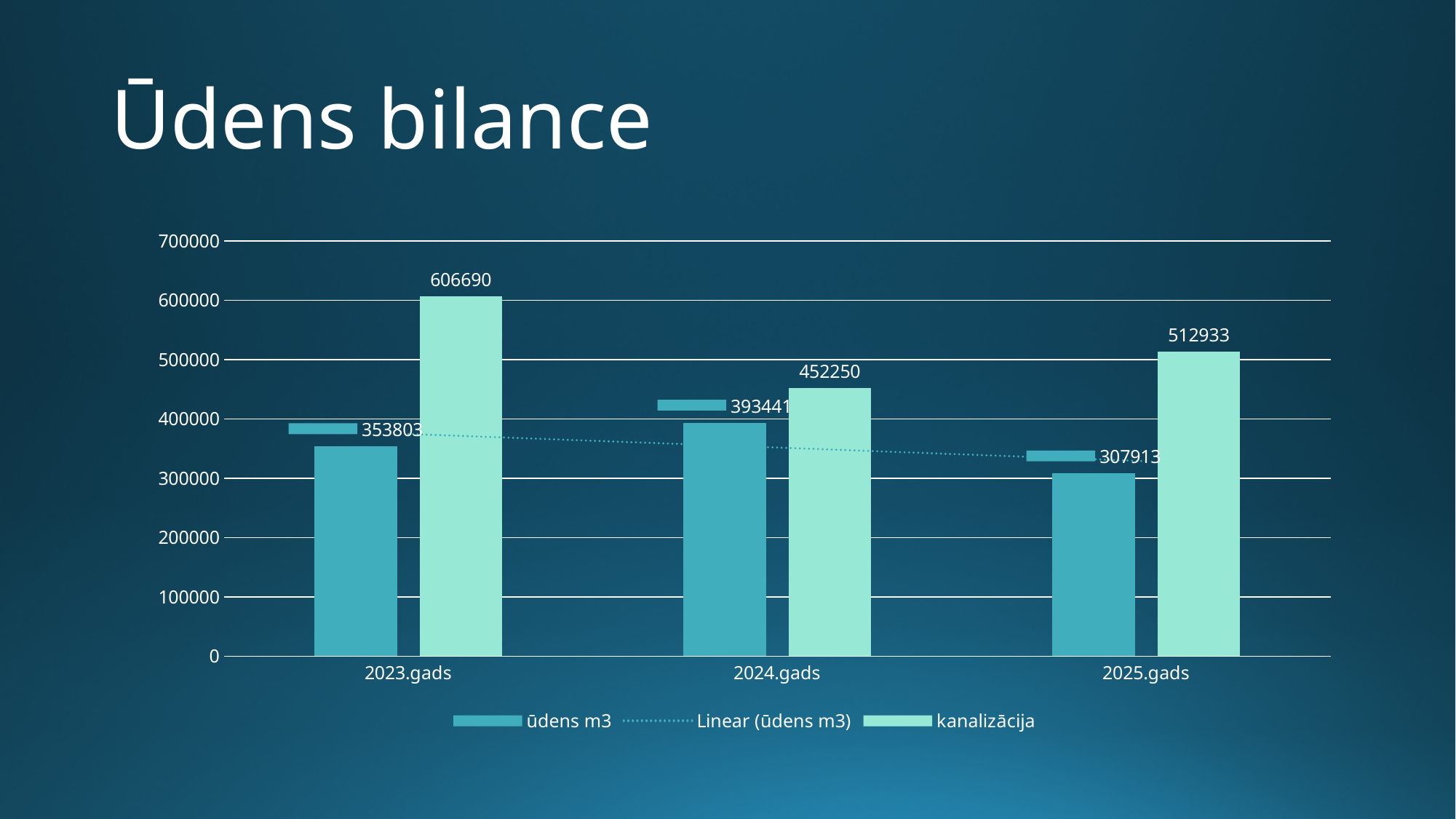
Is the ūdens m3 value for 2025.gads greater or less than 400000? less How many years are shown on the x axis? 3 Which is larger in 2024.gads, ūdens m3 or kanalizācija? kanalizācija Which year has the highest kanalizācija value? 2023.gads How many entries does the legend list? 3 What is the value of kanalizācija for 2025.gads? 512933 What is the value of kanalizācija for 2024.gads? 452250 What is the difference between the kanalizācija values for 2023.gads and 2025.gads? 93757 What is the value of ūdens m3 for 2023.gads? 353803 What kind of chart is shown on the slide? bar chart What is the difference between kanalizācija and ūdens m3 in 2023.gads? 252887 Which year has the lowest ūdens m3 value? 2025.gads